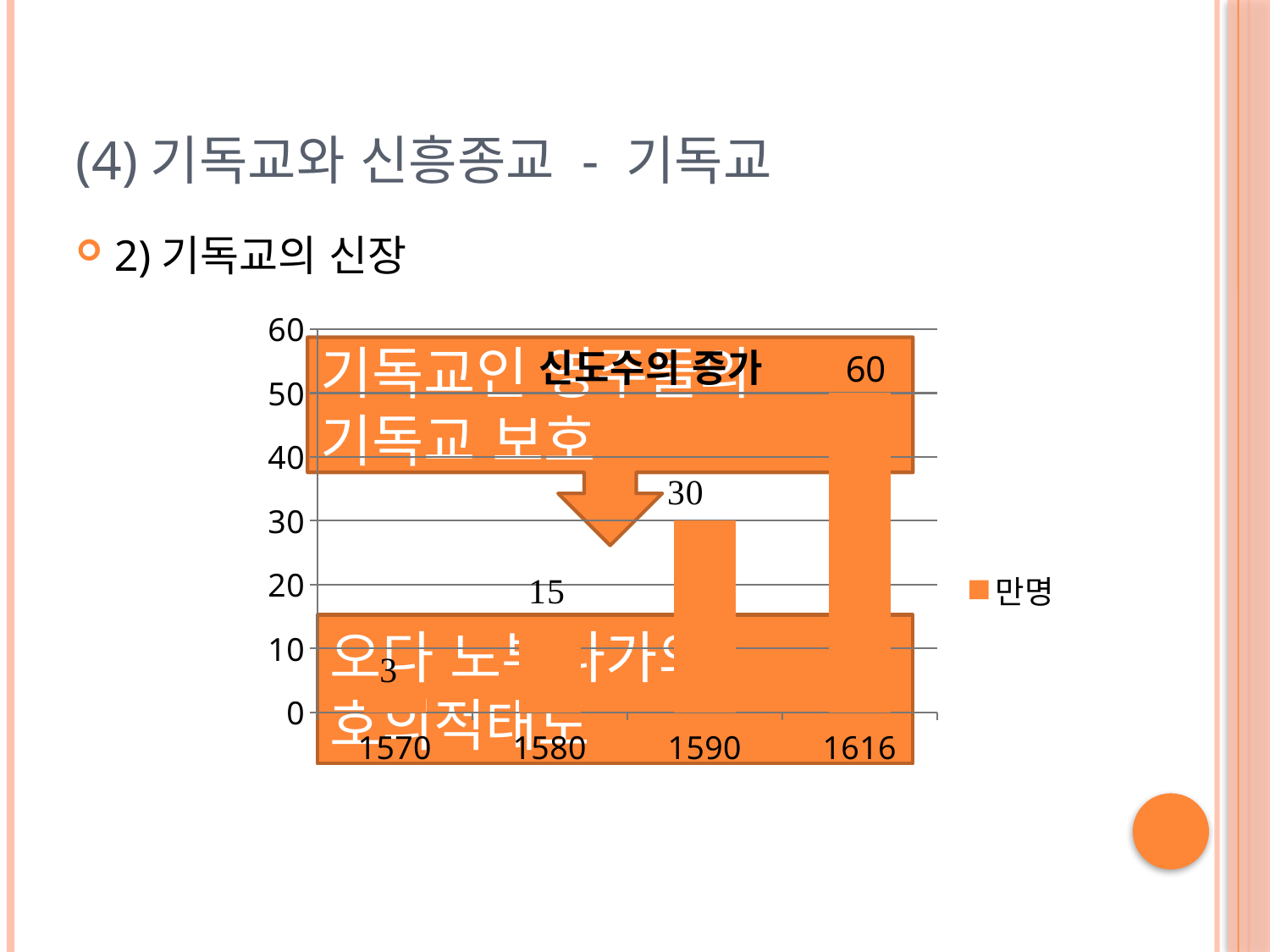
What is the value for 1580 in the chart? 15 Which category has the lowest value in the chart? 1570 What is the value for 1590 in the chart? 30 Do the values rise or fall from 1570 to 1616 along the x axis? rise What is the difference between the values for 1616 and 1590? 30 What series name is listed in the chart legend? 만명 Which is larger, the value for 1580 or the value for 1590? 1590 Which category has the highest value in the chart? 1616 What is the value for 1616 in the chart? 60 What type of chart is shown on the slide? bar chart How many categories are shown on the x axis of the chart? 4 What is the value for 1570 in the chart? 3